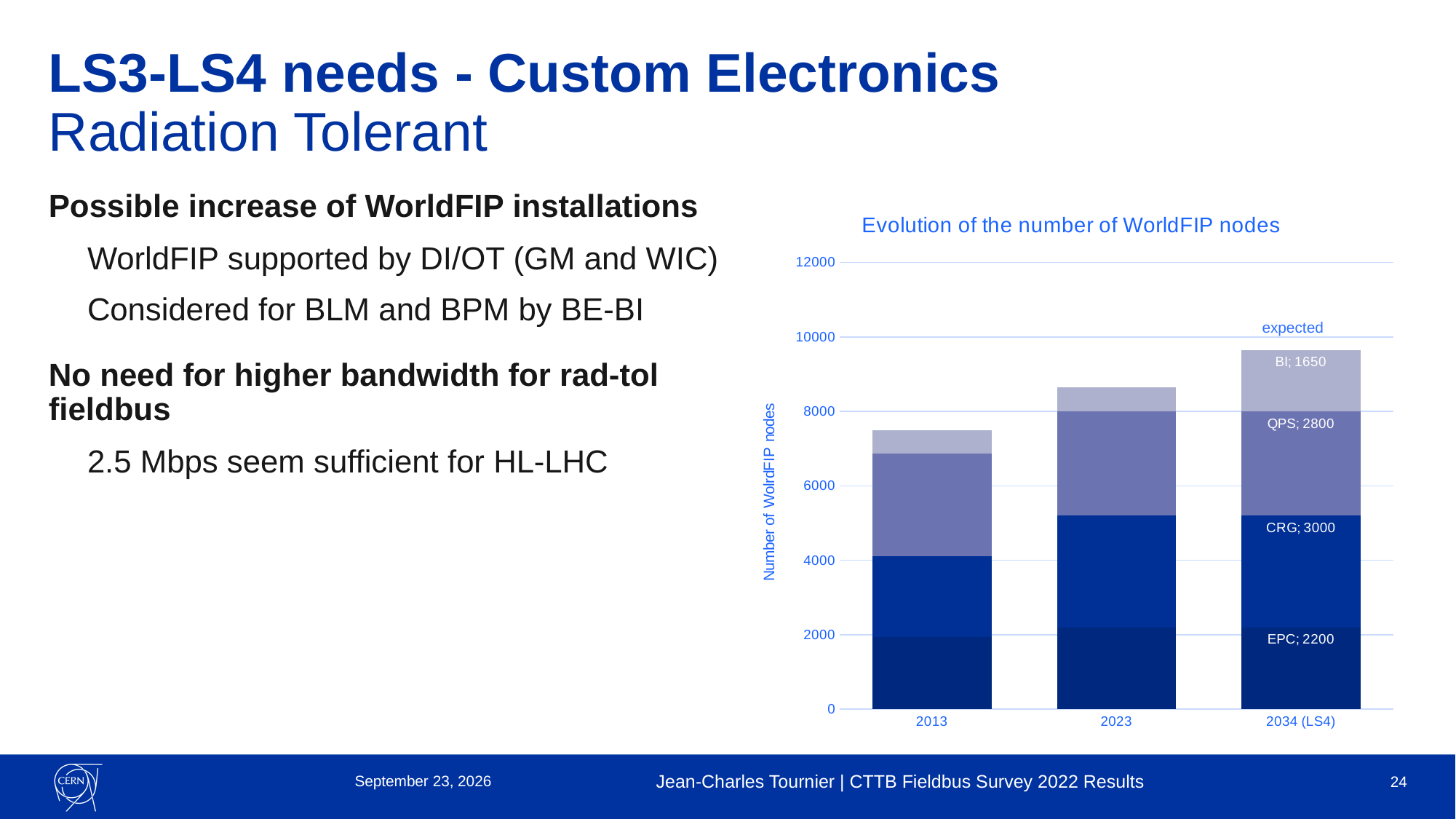
What is the total number of WorldFIP nodes in the 2034 (LS4) bar? 9650 Is the total number of WorldFIP nodes for 2013 greater or less than 8000? less What is the number of EPC nodes in the 2034 (LS4) bar? 2200 What is the number of CRG nodes in the 2034 (LS4) bar? 3000 What is the number of BI nodes in the 2034 (LS4) bar? 1650 In the 2034 (LS4) bar, what is the difference between the CRG and EPC node counts? 800 Which segment of the 2034 (LS4) bar has the largest number of nodes? CRG What type of chart is shown on the slide? Stacked bar chart Which segment of the 2034 (LS4) bar has the smallest number of nodes? BI What is the number of QPS nodes in the 2034 (LS4) bar? 2800 How many years (bars) are shown on the x axis of the chart? 3 Does the total number of WorldFIP nodes rise or fall from 2013 to 2034 (LS4)? Rise